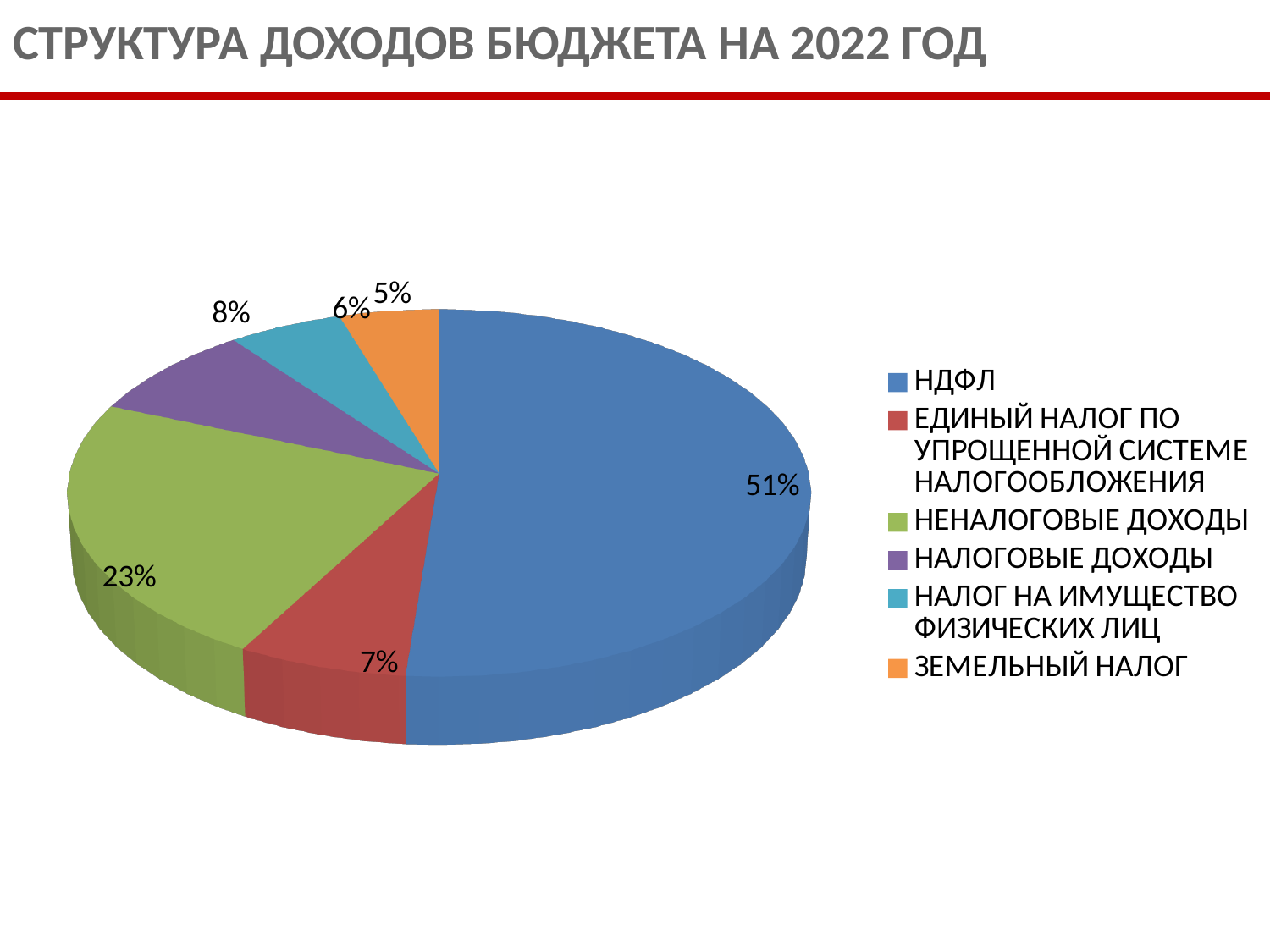
What share of the pie does НДФЛ have? 51% What is the title of the slide? СТРУКТУРА ДОХОДОВ БЮДЖЕТА НА 2022 ГОД What share of the pie does ЗЕМЕЛЬНЫЙ НАЛОГ have? 5% What share of the pie does ЕДИНЫЙ НАЛОГ ПО УПРОЩЕННОЙ СИСТЕМЕ НАЛОГООБЛОЖЕНИЯ have? 7% What kind of chart is shown on the slide? Pie chart What is the difference in percentage points between НДФЛ and НЕНАЛОГОВЫЕ ДОХОДЫ? 28 What share of the pie does НАЛОГОВЫЕ ДОХОДЫ have? 8% Which is larger: НАЛОГОВЫЕ ДОХОДЫ or НАЛОГ НА ИМУЩЕСТВО ФИЗИЧЕСКИХ ЛИЦ? НАЛОГОВЫЕ ДОХОДЫ How many categories does the pie chart have? 6 What share of the pie does НЕНАЛОГОВЫЕ ДОХОДЫ have? 23% Which category has the largest share of the pie? НДФЛ Which category has the smallest share of the pie? ЗЕМЕЛЬНЫЙ НАЛОГ